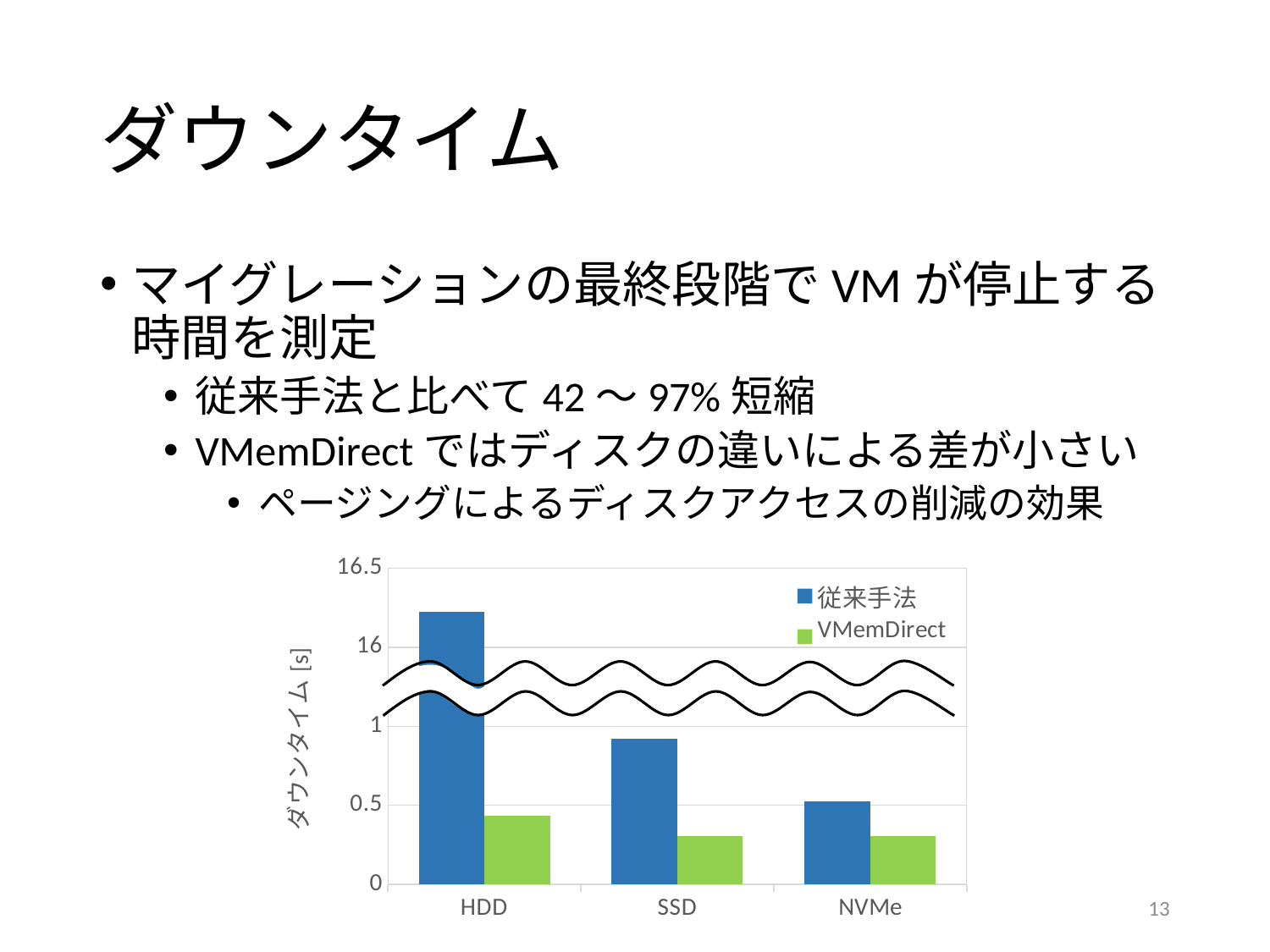
How many categories are shown on the x axis of the chart? 3 Is the VMemDirect value for HDD greater or less than 0.5? less Is the VMemDirect value for SSD greater or less than 0.5? less Which category has the lowest 従来手法 value? NVMe Do the 従来手法 values rise or fall from HDD to NVMe along the x axis? fall What is the label of the y axis of the chart? ダウンタイム [s] Which category has the highest 従来手法 value? HDD What kind of chart is shown on the slide? bar chart Which is larger for SSD: the 従来手法 value or the VMemDirect value? 従来手法 How many series does the chart legend list? 2 Is the 従来手法 value for SSD greater or less than 1? less